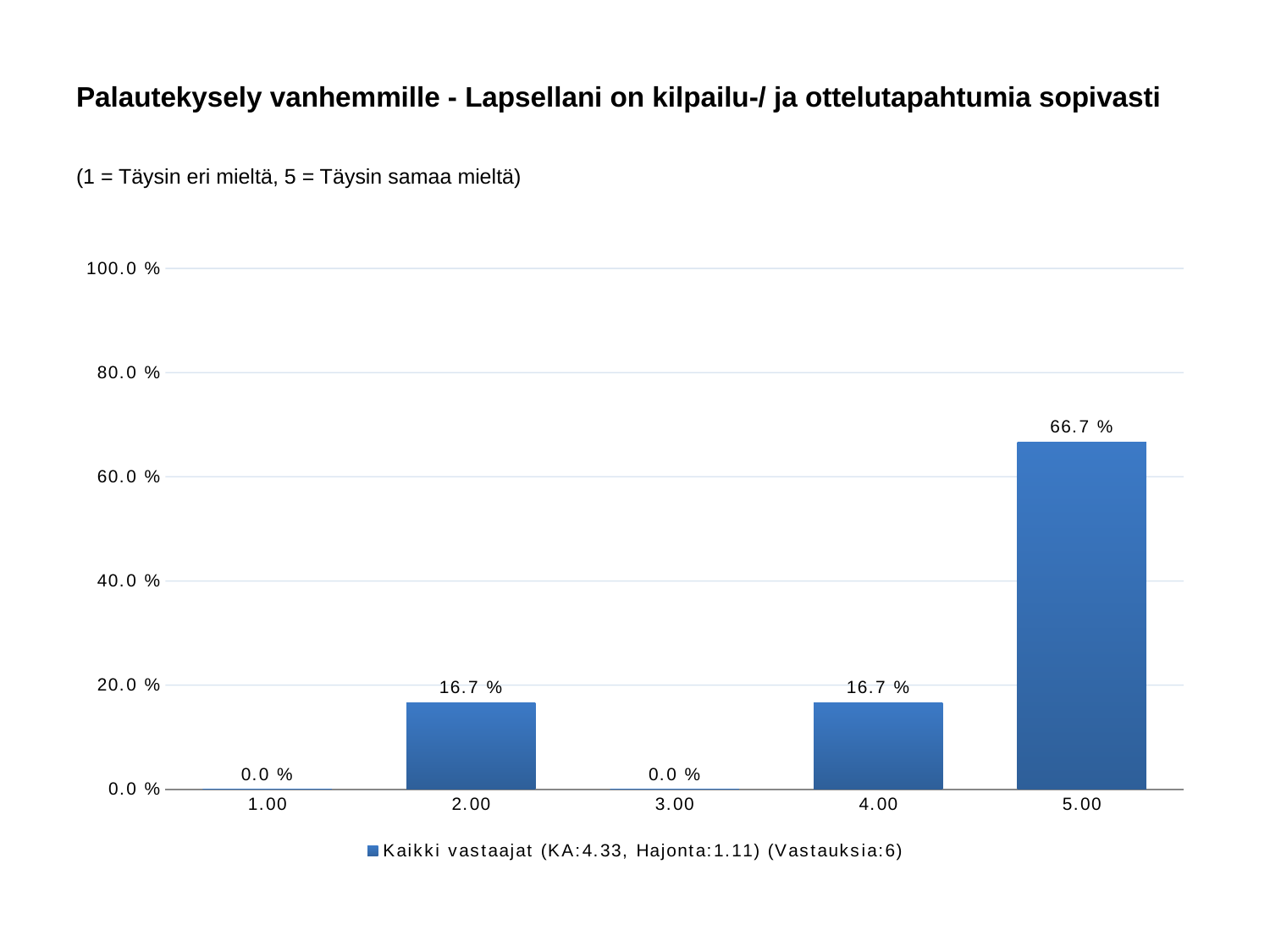
What is the difference between the values for 5.00 and 4.00? 50.0 % What is the value for category 2.00? 16.7 % What is the total of the values for 2.00 and 4.00? 33.4 % How many categories are shown on the x axis? 5 What kind of chart is shown? bar chart How many series does the legend list? 1 What is the value for category 5.00? 66.7 % What is the value for category 1.00? 0.0 % How many responses (Vastauksia) does the legend report? 6 Which category has the highest value? 5.00 Is the value for 5.00 greater or less than 60.0 %? greater Which is larger, the value for 2.00 or the value for 5.00? 5.00